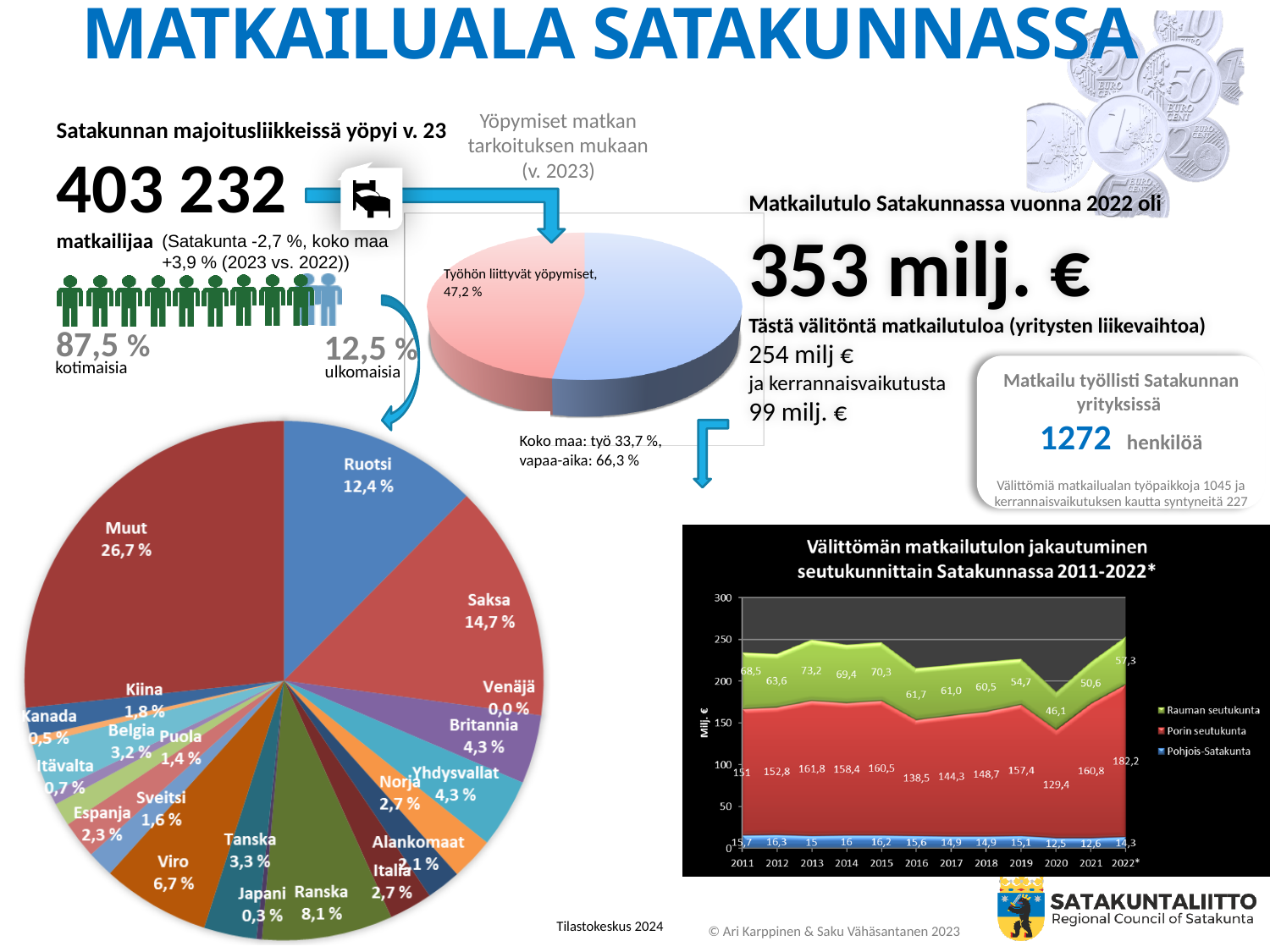
In the large pie chart of visitor countries, how many percentage points larger is Saksa's share than Ruotsi's? 2,3 % In the small pie chart 'Yöpymiset matkan tarkoituksen mukaan (v. 2023)', what share is labelled for Työhön liittyvät yöpymiset? 47,2 % In the chart 'Välittömän matkailutulon jakautuminen seutukunnittain Satakunnassa 2011-2022*', in which year is the Porin seutukunta value lowest? 2020 In the chart 'Välittömän matkailutulon jakautuminen seutukunnittain Satakunnassa 2011-2022*', how many series does the legend list? 3 In the large pie chart of visitor countries, what share does Ruotsi have? 12,4 % In the large pie chart of visitor countries, what share does Saksa have? 14,7 % In the large pie chart of visitor countries, what share is shown for Venäjä? 0,0 % In the chart 'Välittömän matkailutulon jakautuminen seutukunnittain Satakunnassa 2011-2022*', what is the total of the three series in 2022*? 253,8 In the large pie chart of visitor countries, which slice is the largest? Muut In the chart 'Välittömän matkailutulon jakautuminen seutukunnittain Satakunnassa 2011-2022*', what is the value for Rauman seutukunta in 2020? 46,1 In the large pie chart of visitor countries, which has the larger share, Viro or Tanska? Viro In the chart 'Välittömän matkailutulon jakautuminen seutukunnittain Satakunnassa 2011-2022*', what is the value for Porin seutukunta in 2022*? 182,2